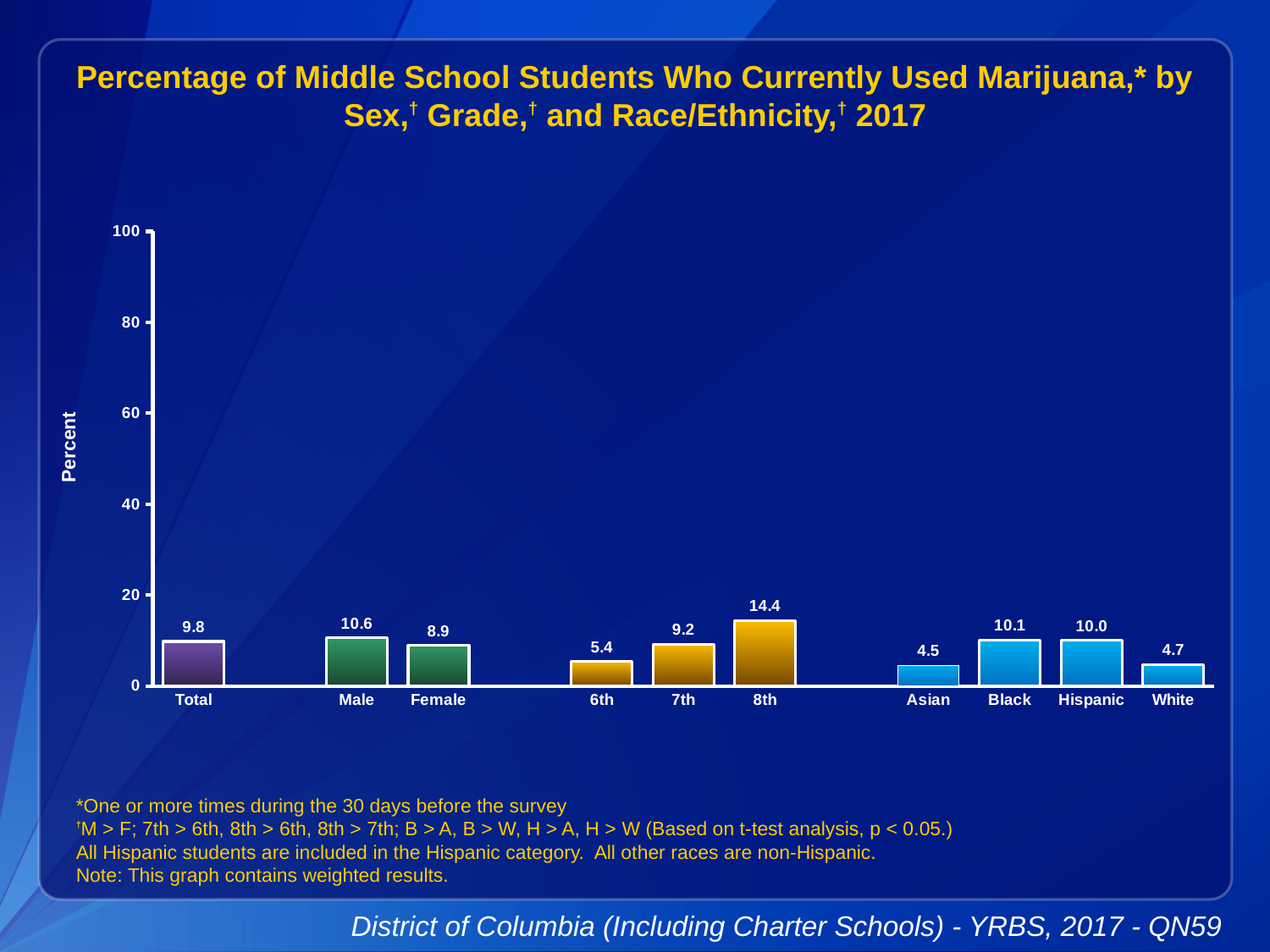
What is the value for 8th grade students? 14.4 What is the difference between the values for 8th and 6th grade? 9.0 What is the value for Asian students? 4.5 What kind of chart is this? bar chart Which category has the lowest value? Asian What is the value for Total? 9.8 Which is larger, the value for Black or the value for White? Black Which category has the highest value? 8th Is the value for 8th grade greater or less than 20? less What is the label of the y axis? Percent What is the difference between the values for Male and Female? 1.7 How many categories are shown on the x axis? 10